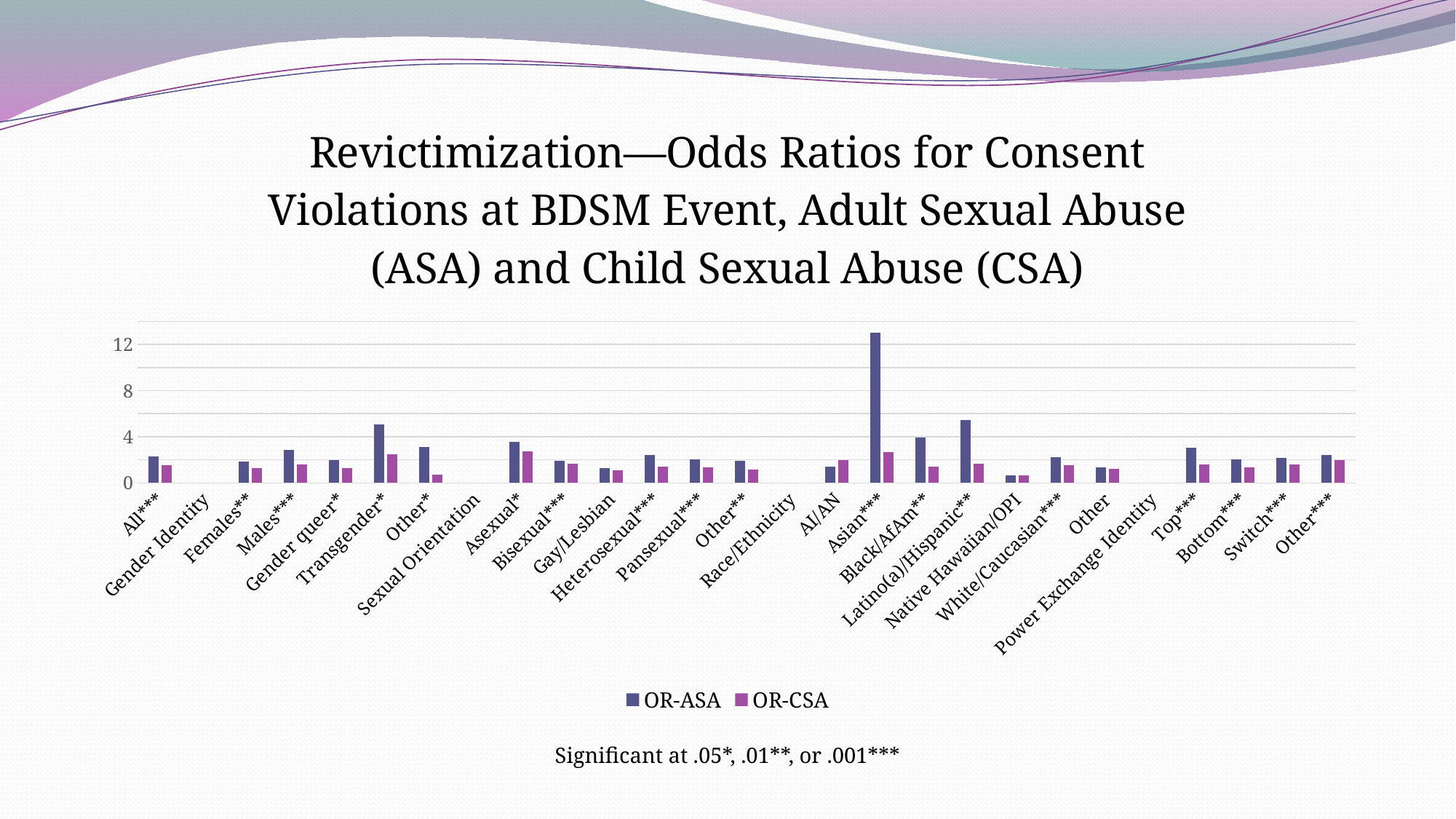
What are the two series named in the legend? OR-ASA and OR-CSA Which category has the lowest OR-ASA value? Native Hawaiian/OPI Is the OR-ASA value for Transgender* greater or less than 4? greater Which is larger, the OR-ASA value for Asian*** or the OR-ASA value for Latino(a)/Hispanic**? Asian*** Which category has the highest OR-ASA value? Asian*** Is the OR-ASA value for Asian*** greater or less than 8? greater How many series does the legend list? 2 For Asian***, which is larger, OR-ASA or OR-CSA? OR-ASA Is the OR-ASA value for Latino(a)/Hispanic** greater or less than 4? greater For AI/AN, which is larger, OR-ASA or OR-CSA? OR-CSA What kind of chart is shown on the slide? bar chart